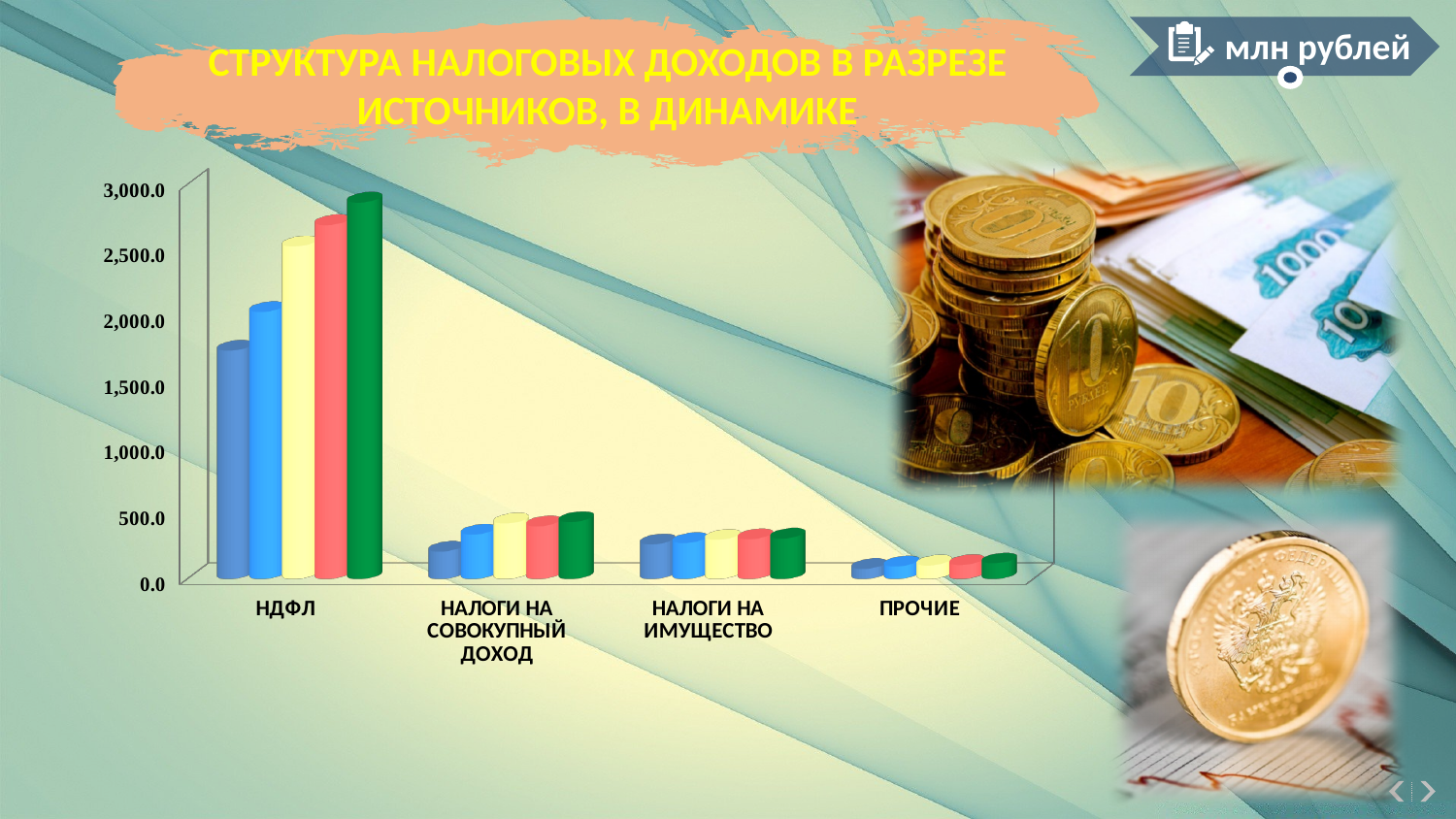
How many bars are plotted for each category in the chart? 5 Do the bars for НДФЛ rise or fall from left to right within the category? rise Which category has the highest bars in the chart? НДФЛ Are the bars for ПРОЧИЕ greater or less than 500.0? less How many categories are shown on the x axis of the chart? 4 Are the bars for НАЛОГИ НА ИМУЩЕСТВО greater or less than 500.0? less Is the value of the tallest (green) bar for НДФЛ greater or less than 2,500.0? greater Which category has the larger green bar: НАЛОГИ НА СОВОКУПНЫЙ ДОХОД or НАЛОГИ НА ИМУЩЕСТВО? НАЛОГИ НА СОВОКУПНЫЙ ДОХОД What is the highest value shown on the vertical axis of the chart? 3,000.0 What kind of chart is shown on the slide? Bar chart Which category has the lowest bars in the chart? ПРОЧИЕ